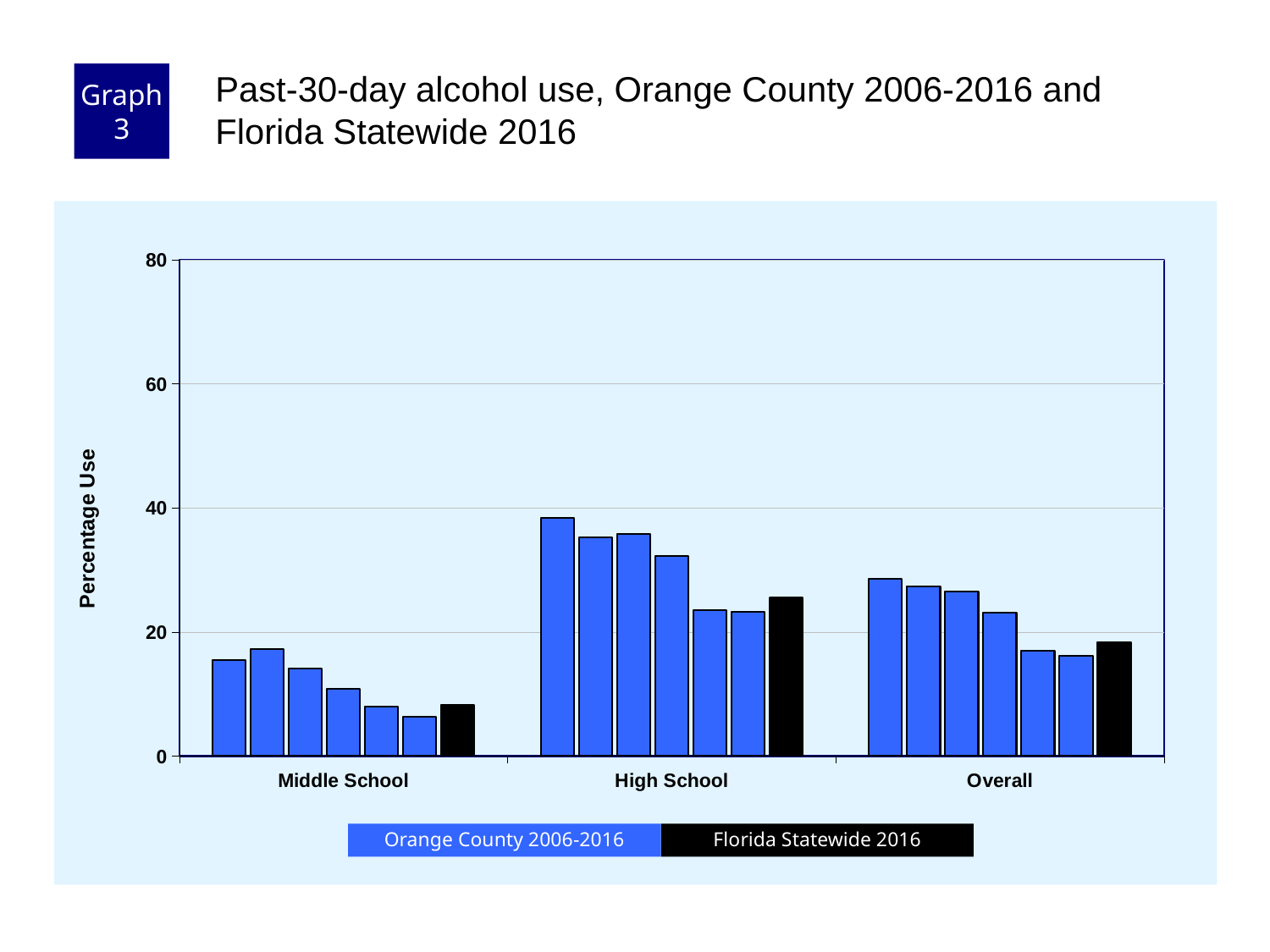
In the Middle School group, which is larger: the Florida Statewide 2016 bar or the rightmost Orange County 2006-2016 bar? Florida Statewide 2016 How many series does the legend list? 2 Do the Orange County 2006-2016 bars for High School rise or fall from left to right? fall How many categories are shown on the x axis? 3 Is the Florida Statewide 2016 value for High School greater or less than 20? greater What is the title of the y axis? Percentage Use Is the Florida Statewide 2016 value for Middle School greater or less than 20? less What kind of chart is shown on the slide? Bar chart Which category has the lowest percentage use values? Middle School Which category has the highest percentage use values? High School Is the Florida Statewide 2016 value for Overall greater or less than 10? greater Which is larger, the Florida Statewide 2016 value for High School or for Overall? High School